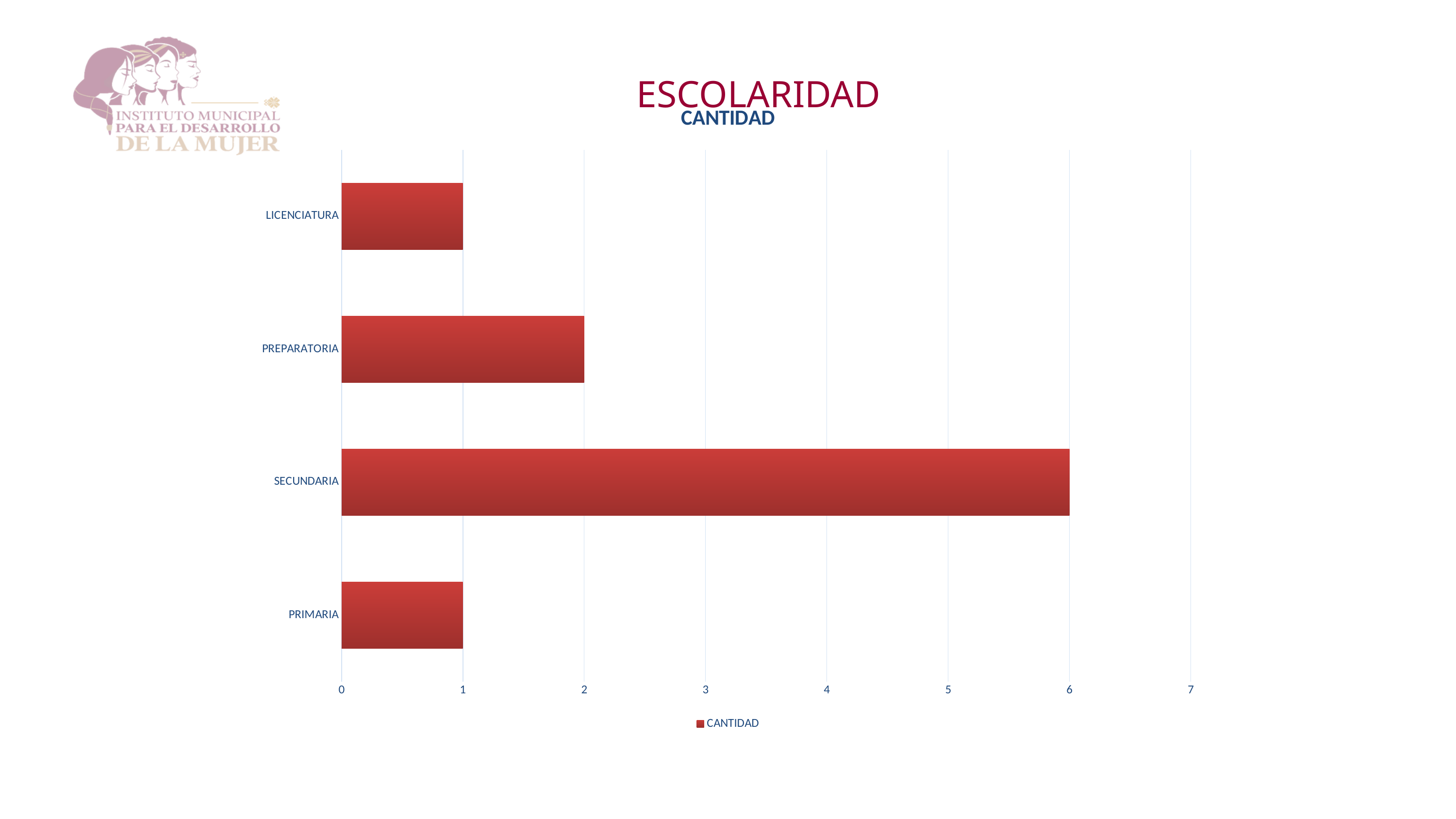
What is the difference between the values for PREPARATORIA and LICENCIATURA? 1 What is the value for PRIMARIA? 1 What is the value for PREPARATORIA? 2 What kind of chart is shown on the slide? bar chart Is the value for SECUNDARIA greater or less than 5? greater Which is larger, the value for PREPARATORIA or the value for PRIMARIA? PREPARATORIA How many categories are shown in the chart? 4 Which category has the highest value? SECUNDARIA What is the value for SECUNDARIA? 6 What is the difference between the values for SECUNDARIA and PREPARATORIA? 4 What is the title of the chart? CANTIDAD What is the value for LICENCIATURA? 1